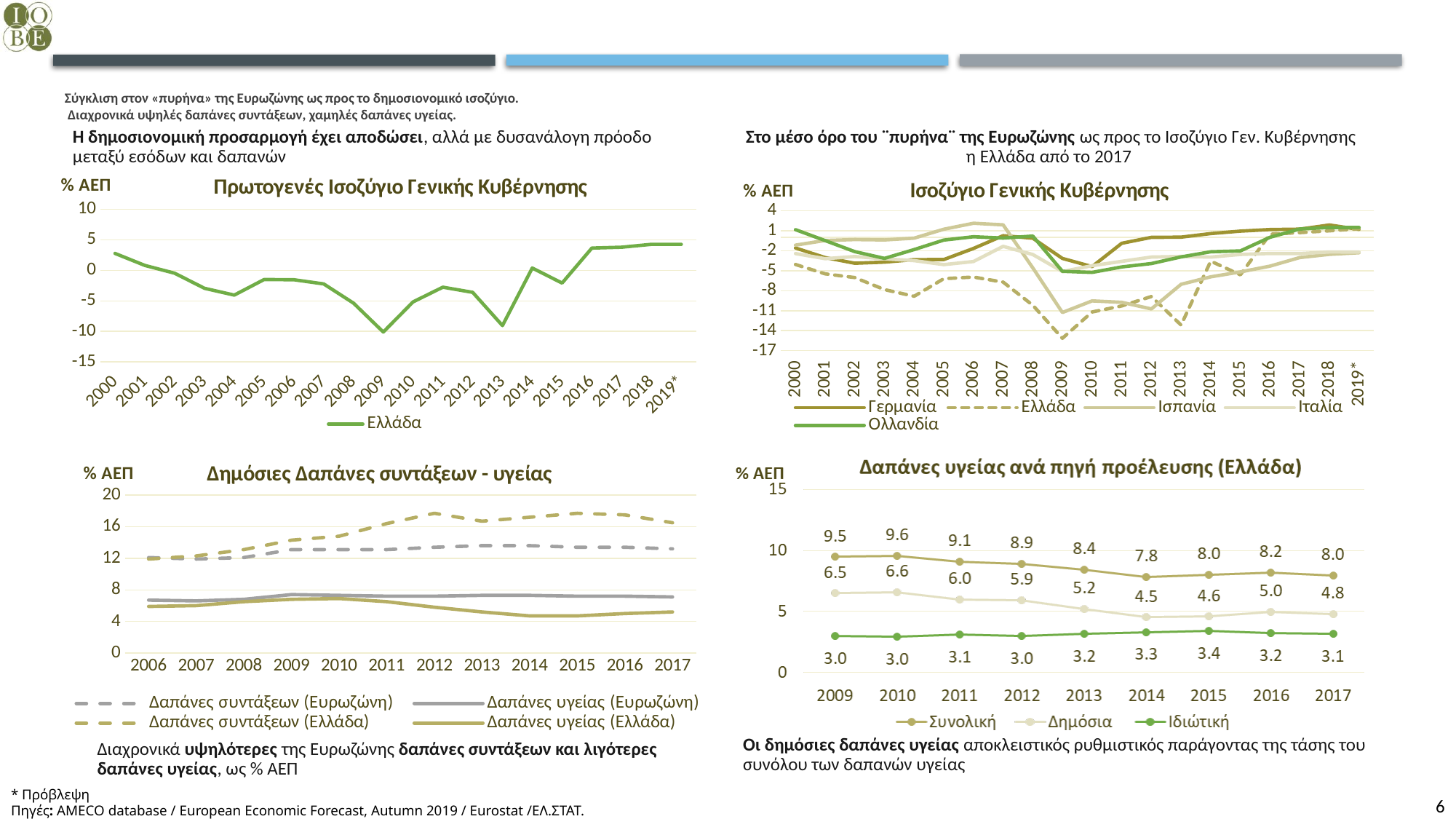
In the chart 'Πρωτογενές Ισοζύγιο Γενικής Κυβέρνησης', is the value for Ελλάδα in 2009 greater or less than -5? less In the chart 'Ισοζύγιο Γενικής Κυβέρνησης', how many series does the legend list? 5 In the chart 'Πρωτογενές Ισοζύγιο Γενικής Κυβέρνησης', in which year is the value for Ελλάδα lowest? 2009 In the chart 'Δαπάνες υγείας ανά πηγή προέλευσης (Ελλάδα)', what is the difference between Συνολική in 2009 and Συνολική in 2017? 1.5 In the chart 'Δαπάνες υγείας ανά πηγή προέλευσης (Ελλάδα)', in which year is Συνολική highest? 2010 In the chart 'Δαπάνες υγείας ανά πηγή προέλευσης (Ελλάδα)', does Δημόσια rise or fall from 2009 to 2014? fall In the chart 'Δαπάνες υγείας ανά πηγή προέλευσης (Ελλάδα)', how many series does the legend list? 3 In the chart 'Δαπάνες υγείας ανά πηγή προέλευσης (Ελλάδα)', what is the value for Συνολική in 2010? 9.6 In the chart 'Δημόσιες Δαπάνες συντάξεων - υγείας', which is larger in 2017: Δαπάνες συντάξεων (Ελλάδα) or Δαπάνες συντάξεων (Ευρωζώνη)? Δαπάνες συντάξεων (Ελλάδα) In the chart 'Δαπάνες υγείας ανά πηγή προέλευσης (Ελλάδα)', in which year is Δημόσια lowest? 2014 In the chart 'Δαπάνες υγείας ανά πηγή προέλευσης (Ελλάδα)', what is the value for Δημόσια in 2014? 4.5 In the chart 'Δαπάνες υγείας ανά πηγή προέλευσης (Ελλάδα)', what is the value for Ιδιωτική in 2015? 3.4